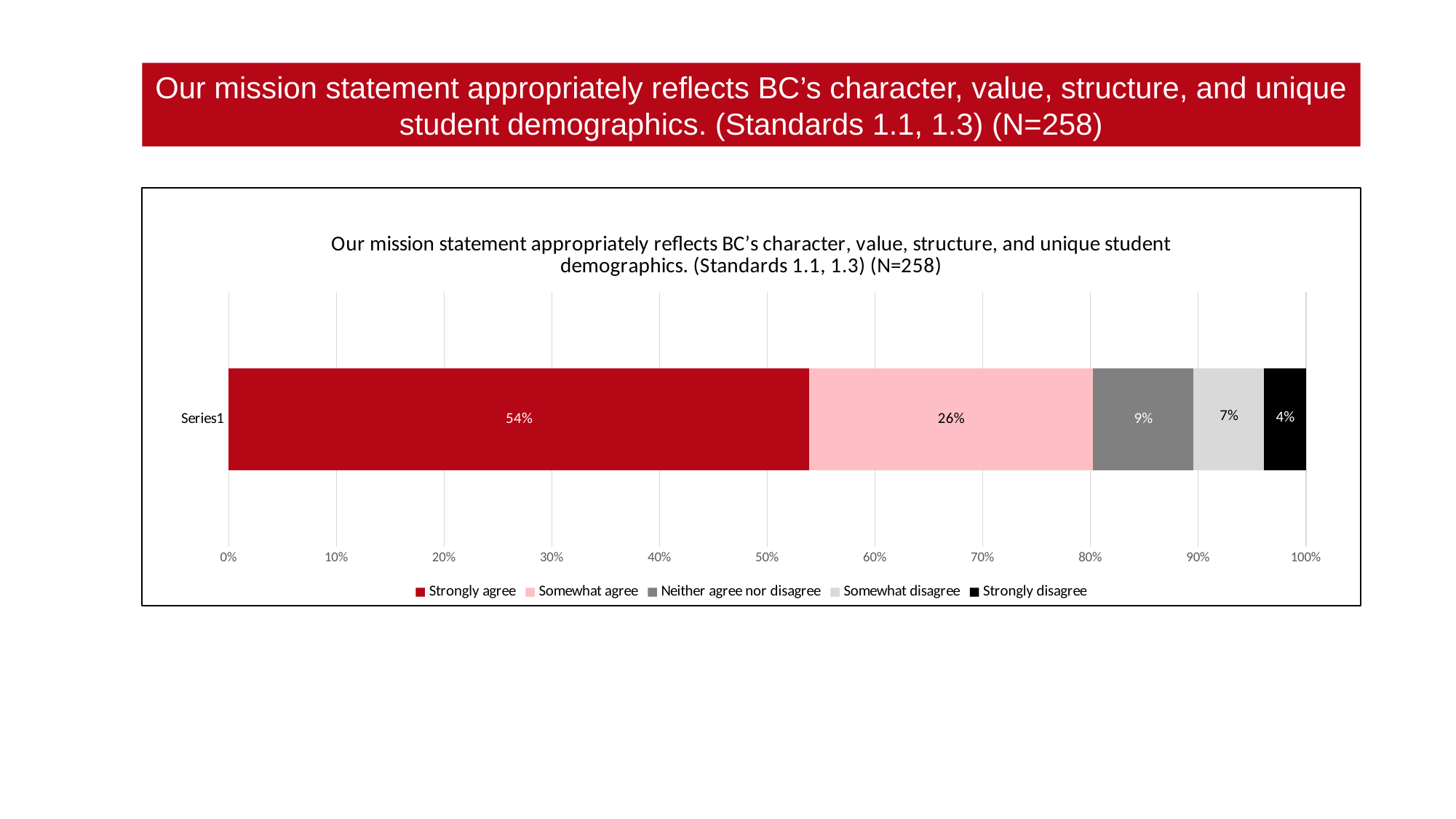
What is the difference between the "Strongly agree" and "Somewhat agree" percentages? 28 percentage points How many series does the legend list? 5 Which response option has the largest share? Strongly agree What percentage of respondents selected "Somewhat agree"? 26% What percentage of respondents selected "Somewhat disagree"? 7% What percentage of respondents selected "Strongly disagree"? 4% What percentage of respondents selected "Neither agree nor disagree"? 9% What kind of chart is shown on the slide? Stacked bar chart What is the combined percentage of "Strongly agree" and "Somewhat agree" responses? 80% Which response option has the smallest share? Strongly disagree Which is larger, the share for "Neither agree nor disagree" or the share for "Somewhat disagree"? Neither agree nor disagree What percentage of respondents selected "Strongly agree"? 54%